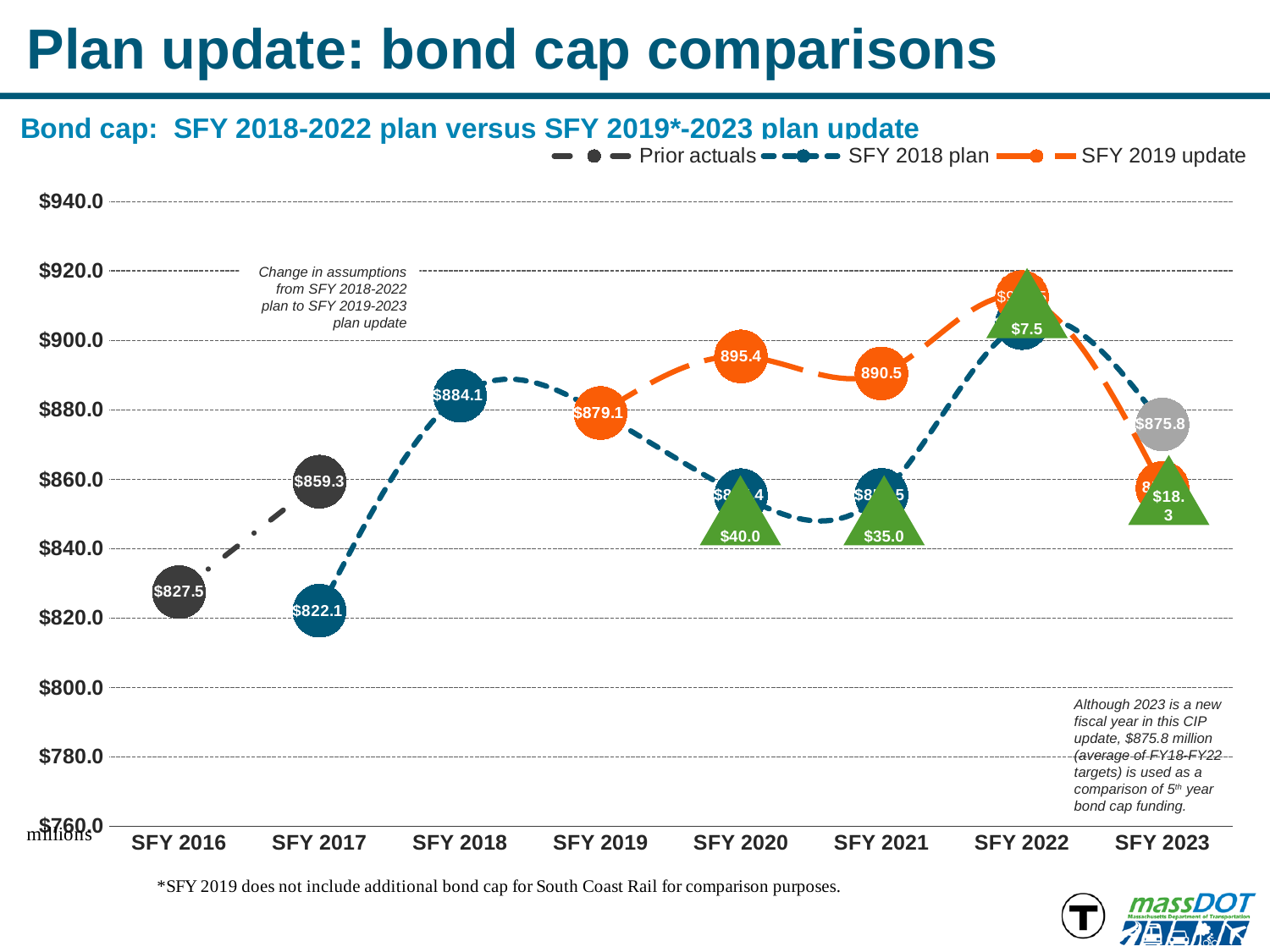
Is the SFY 2018 plan value for SFY 2022 greater or less than $900.0? greater What is the Prior actuals value for SFY 2017? $859.3 What is the SFY 2018 plan value for SFY 2017? $822.1 How many fiscal years are shown on the x axis? 8 What is the Prior actuals value for SFY 2016? $827.5 What is the SFY 2018 plan value for SFY 2018? $884.1 For SFY 2017, which is larger: the Prior actuals value or the SFY 2018 plan value? Prior actuals What is the SFY 2019 update value for SFY 2021? 890.5 What is the change in assumptions shown in the green triangle for SFY 2020? $40.0 What is the difference between the SFY 2019 update values for SFY 2020 and SFY 2021? 4.9 What is the SFY 2019 update value for SFY 2020? 895.4 How many series does the legend list? 3